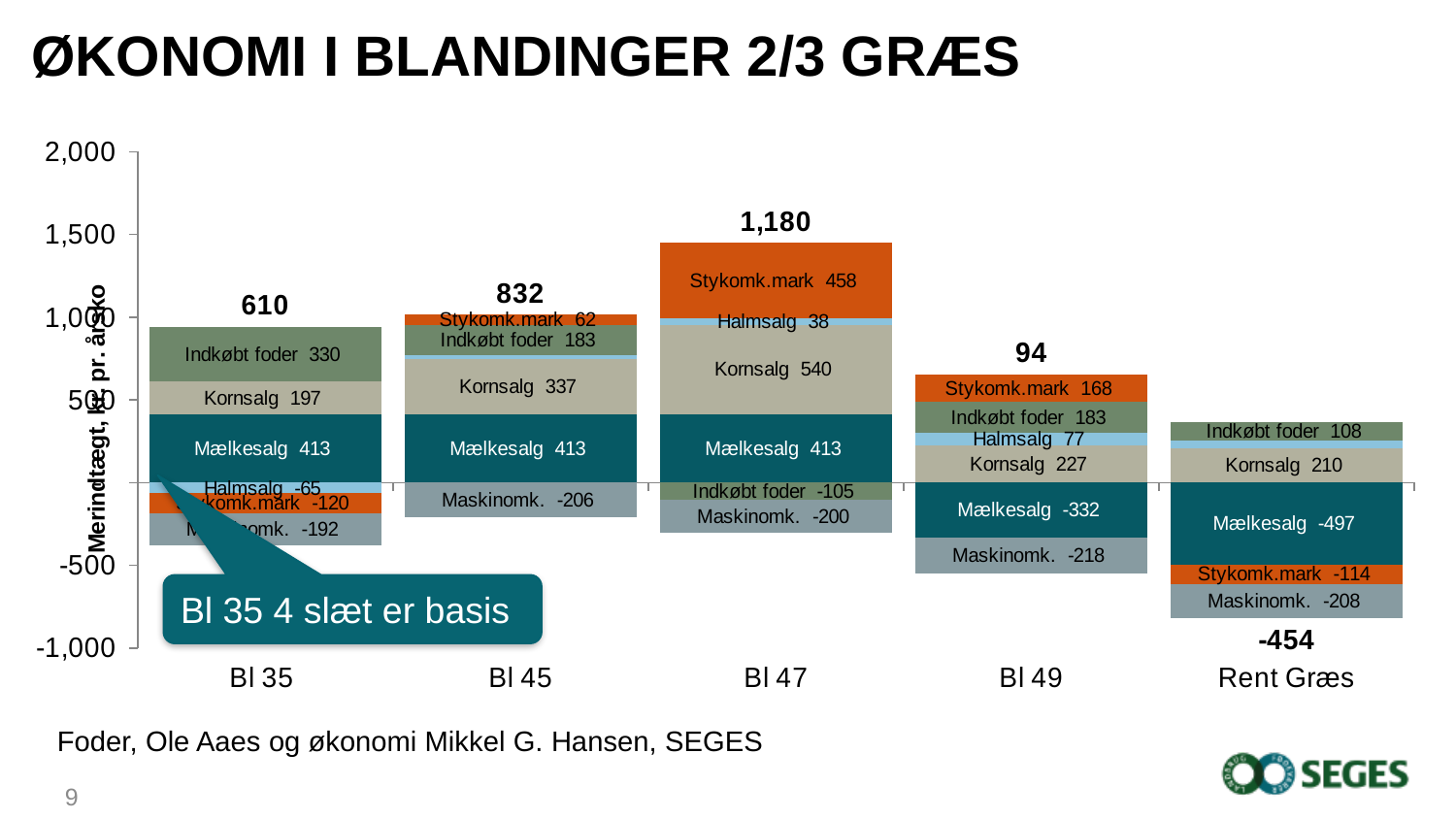
What kind of chart is shown on the slide? Stacked bar chart What is the Kornsalg value in the Bl 47 bar? 540 What is the total value shown above the bar for Bl 47? 1,180 What is the total value shown for Rent Græs? -454 What is the difference between the totals for Bl 45 and Bl 35? 222 What is the Stykomk.mark value in the Bl 49 bar? 168 Which category has the lowest total value? Rent Græs How many categories are shown on the x axis? 5 What is the Mælkesalg value in the Rent Græs bar? -497 Which has a larger total, Bl 49 or Bl 45? Bl 45 Which category has the highest total value? Bl 47 What is the Indkøbt foder value in the Bl 35 bar? 330